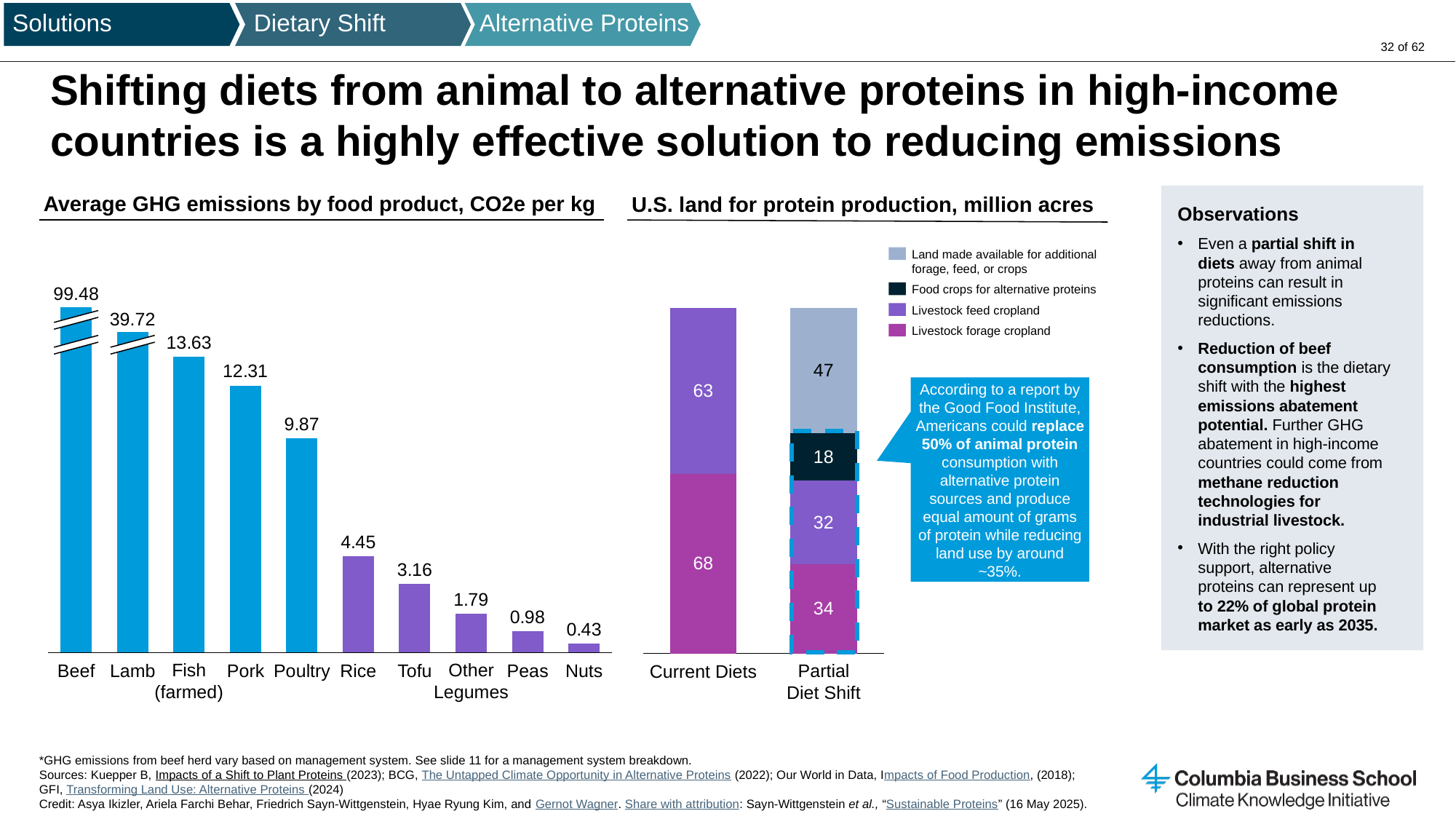
In the 'Average GHG emissions by food product, CO2e per kg' chart, which food product has the highest emissions? Beef In the 'Average GHG emissions by food product, CO2e per kg' chart, what is the value for Tofu? 3.16 In the 'Average GHG emissions by food product, CO2e per kg' chart, what is the difference between the values for Fish (farmed) and Pork? 1.32 How many food products are shown in the 'Average GHG emissions by food product, CO2e per kg' chart? 10 In the 'U.S. land for protein production, million acres' chart, what is the value for Livestock feed cropland under Current Diets? 63 In the 'U.S. land for protein production, million acres' chart, what is the total of the Current Diets stacked bar? 131 In the 'Average GHG emissions by food product, CO2e per kg' chart, what is the value for Lamb? 39.72 In the 'Average GHG emissions by food product, CO2e per kg' chart, which food product has the lowest emissions? Nuts In the 'Average GHG emissions by food product, CO2e per kg' chart, which has a higher value, Rice or Poultry? Poultry How many series does the legend of the 'U.S. land for protein production, million acres' chart list? 4 What kind of chart is the 'Average GHG emissions by food product, CO2e per kg' chart? Bar chart In the 'U.S. land for protein production, million acres' chart, what is the value for Food crops for alternative proteins under Partial Diet Shift? 18